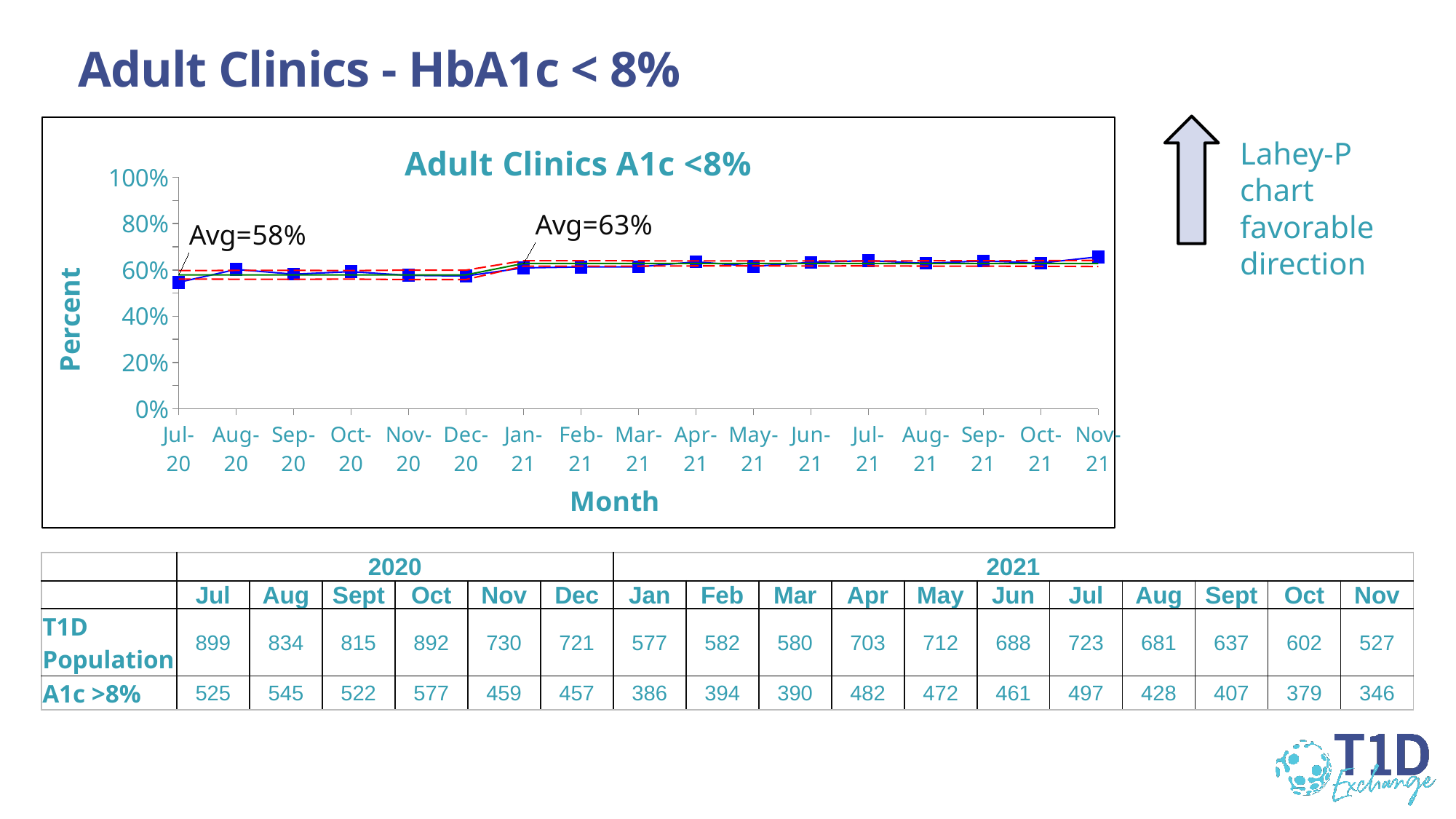
By how many percentage points does the second annotated average (Avg=63%) exceed the first (Avg=58%)? 5 Do the plotted values generally rise or fall from Jul-20 to Nov-21? rise How many monthly data points are plotted on the chart? 17 Which month has the lowest plotted value on the chart? Jul-20 Is the value for Jul-21 greater or less than 80%? less What average value is annotated for the first period of the chart (starting Jul-20)? 58% Which is larger, the value for Jul-20 or the value for Nov-21? Nov-21 What is the title of the chart? Adult Clinics A1c <8% Is the value for Nov-21 greater or less than 60%? greater What kind of chart is shown on the slide? line chart What average value is annotated for the second period of the chart (starting Jan-21)? 63% Is the value for Jul-20 greater or less than 60%? less